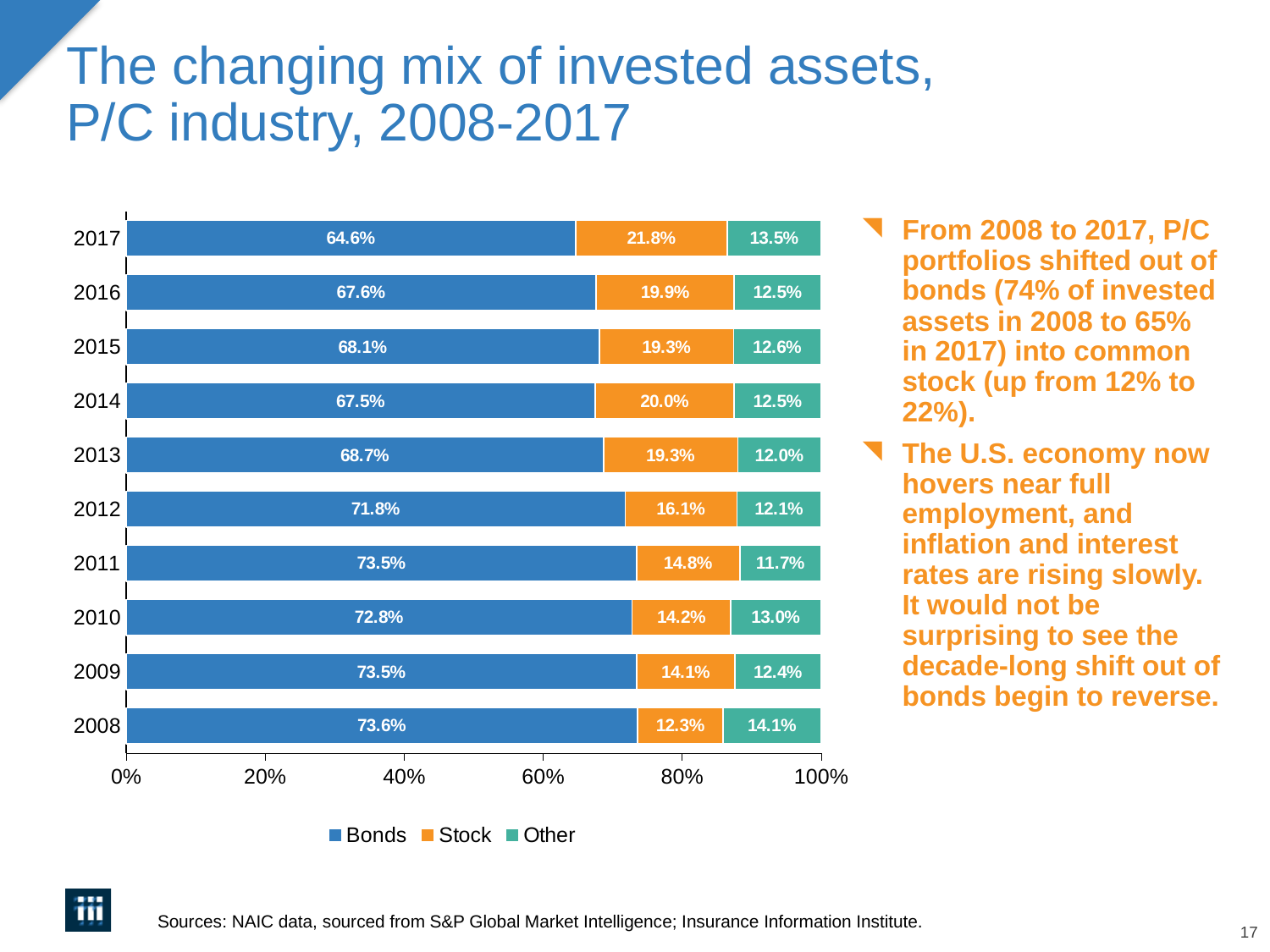
What share of invested assets was in bonds in 2017? 64.6% In which year was the Bonds share the lowest? 2017 What was the Stock share in 2012? 16.1% Did the Bonds share rise or fall from 2008 to 2017? Fall What was the Other share in 2008? 14.1% In which year was the Other share the lowest? 2011 What type of chart is shown on the slide? Stacked bar chart Which was larger in 2014, the Stock share or the Other share? Stock How many years are shown in the chart? 10 In which year was the Stock share the highest? 2017 By how many percentage points did the Stock share increase from 2008 to 2017? 9.5 percentage points How many series does the legend list? 3